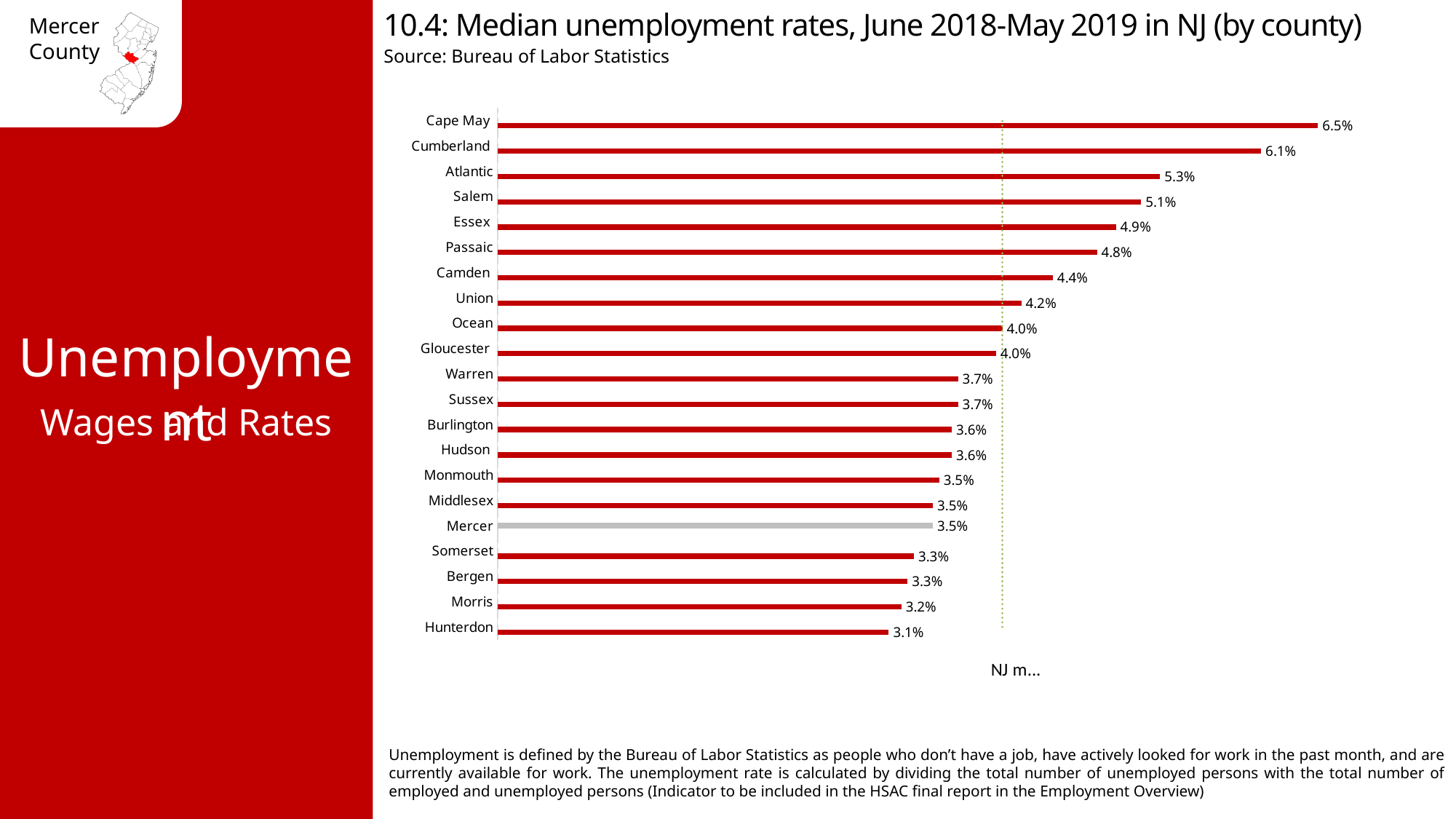
What is the difference between the median unemployment rates of Cape May and Hunterdon? 3.4% What is the median unemployment rate for Camden? 4.4% What is the median unemployment rate for Cape May? 6.5% Which county has a higher median unemployment rate, Morris or Passaic? Passaic How many counties are shown in the chart? 21 Which county has the highest median unemployment rate? Cape May Which county has a higher median unemployment rate, Essex or Union? Essex What is the difference between the median unemployment rates of Cumberland and Mercer? 2.6% What is the median unemployment rate for Mercer? 3.5% What kind of chart is shown on the slide? Bar chart Which county has the lowest median unemployment rate? Hunterdon Which county's bar is coloured grey instead of red? Mercer